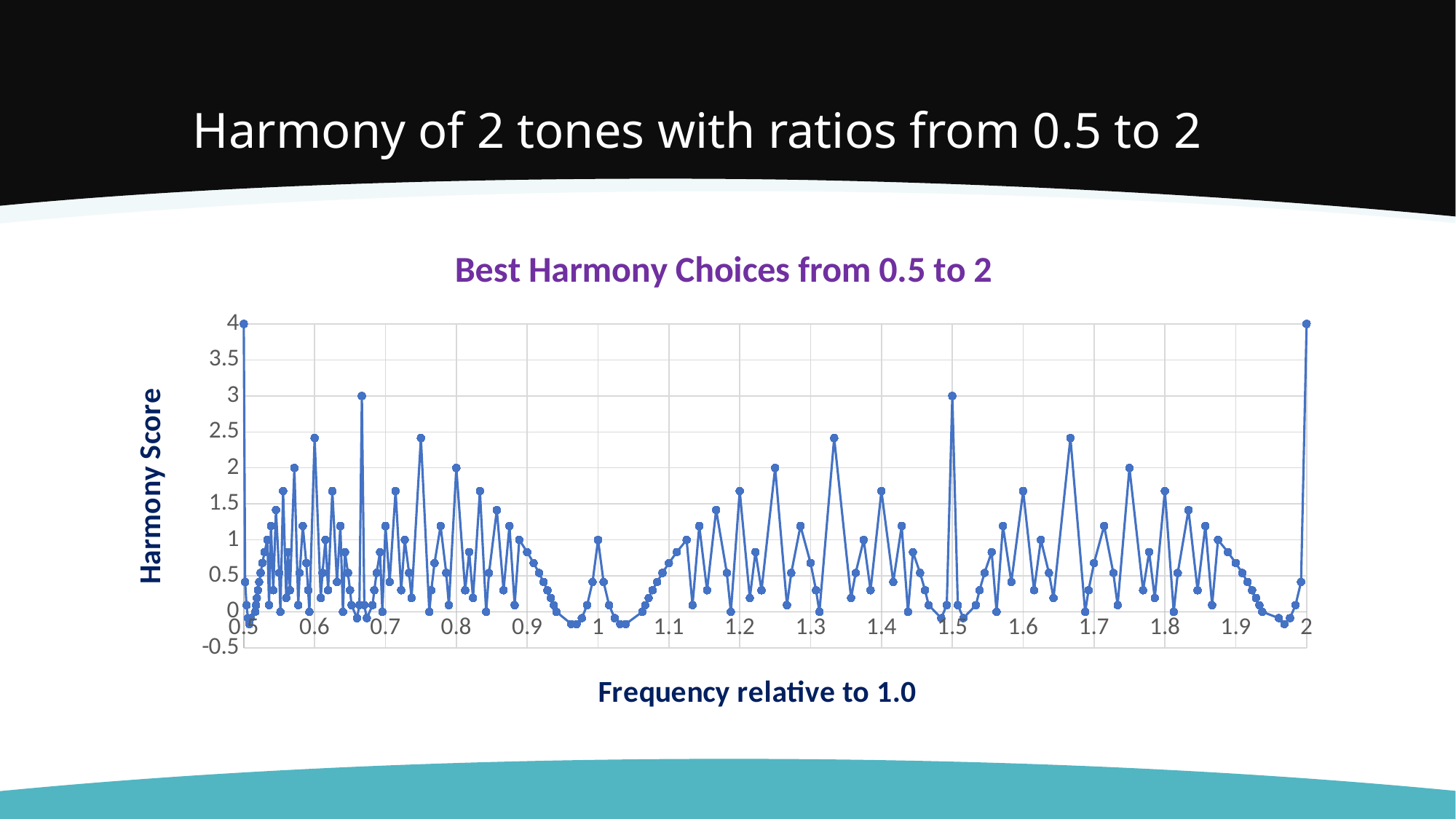
What is the highest harmony score plotted on the chart? 4 What is the harmony score at a frequency ratio of 0.5? 4 What is the title of the chart? Best Harmony Choices from 0.5 to 2 What kind of chart is shown on the slide? line chart What is the label of the vertical axis? Harmony Score Between frequency ratios of 1.05 and 1.1, do the harmony scores rise or fall? rise What is the harmony score at a frequency ratio of 2? 4 Is the harmony score at a frequency ratio of 1.5 greater or less than 2? greater Which has the larger harmony score: a frequency ratio of 1.5 or a frequency ratio of 1? 1.5 What is the harmony score at a frequency ratio of 1? 1 What is the harmony score at a frequency ratio of 1.5? 3 Is the harmony score at a frequency ratio of 1 greater or less than 2? less